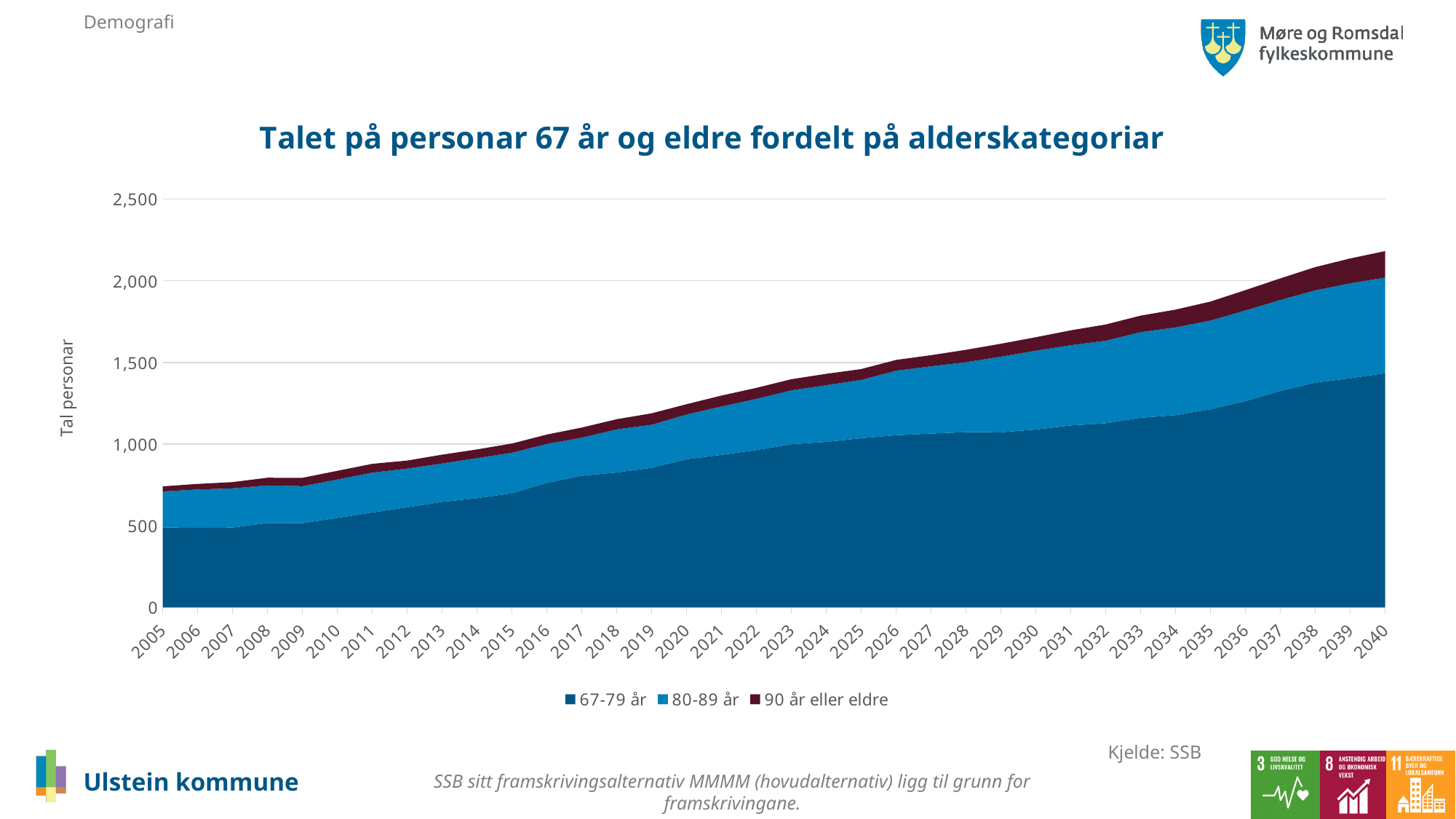
How many series does the legend list? 3 Is the value for the 67-79 år series in 2040 greater or less than 1,000? greater Which year has the highest total number of persons 67 years and older? 2040 Is the total value for 2020 greater or less than 1,000? greater Is the value for the 67-79 år series in 2040 greater or less than 1,500? less How many years are shown along the x axis? 36 What is the title of the chart? Talet på personar 67 år og eldre fordelt på alderskategoriar Does the total number of persons 67 years and older rise or fall from 2005 to 2040? Rise What is the label of the y axis? Tal personar What kind of chart is shown on the slide? Stacked area chart